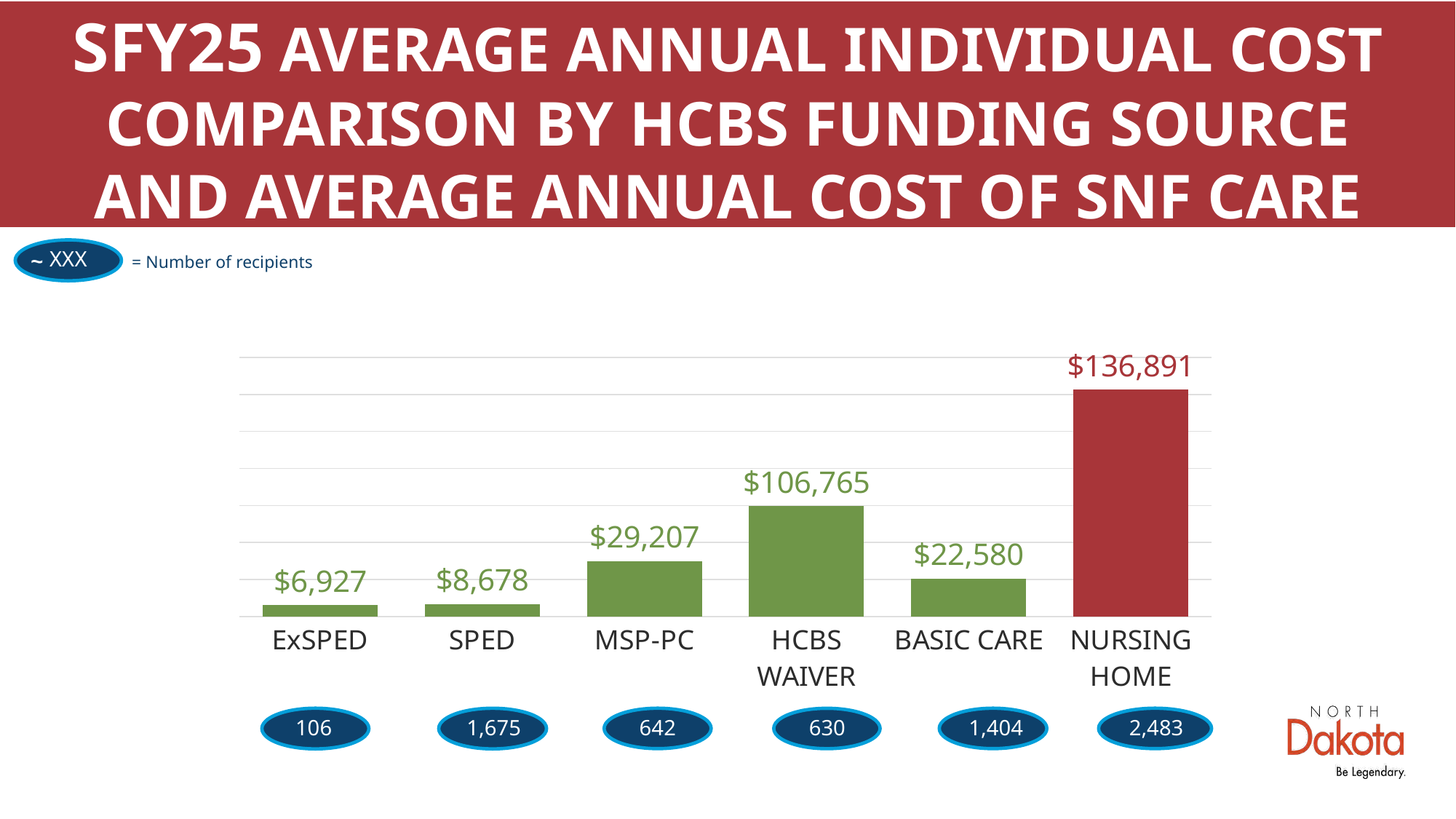
Which category has the lowest average annual cost? ExSPED Which category has the highest average annual cost? NURSING HOME What is the difference between the NURSING HOME cost and the HCBS WAIVER cost? $30,126 How many categories are shown on the chart? 6 What is the difference between the MSP-PC cost and the SPED cost? $20,529 What is the average annual individual cost for BASIC CARE? $22,580 Which is larger, the cost for MSP-PC or the cost for BASIC CARE? MSP-PC What kind of chart is shown on the slide? Bar chart What is the average annual cost shown for NURSING HOME? $136,891 How many recipients are shown in the oval below the NURSING HOME bar? 2,483 What is the average annual individual cost for the HCBS WAIVER category? $106,765 What is the average annual individual cost for ExSPED? $6,927